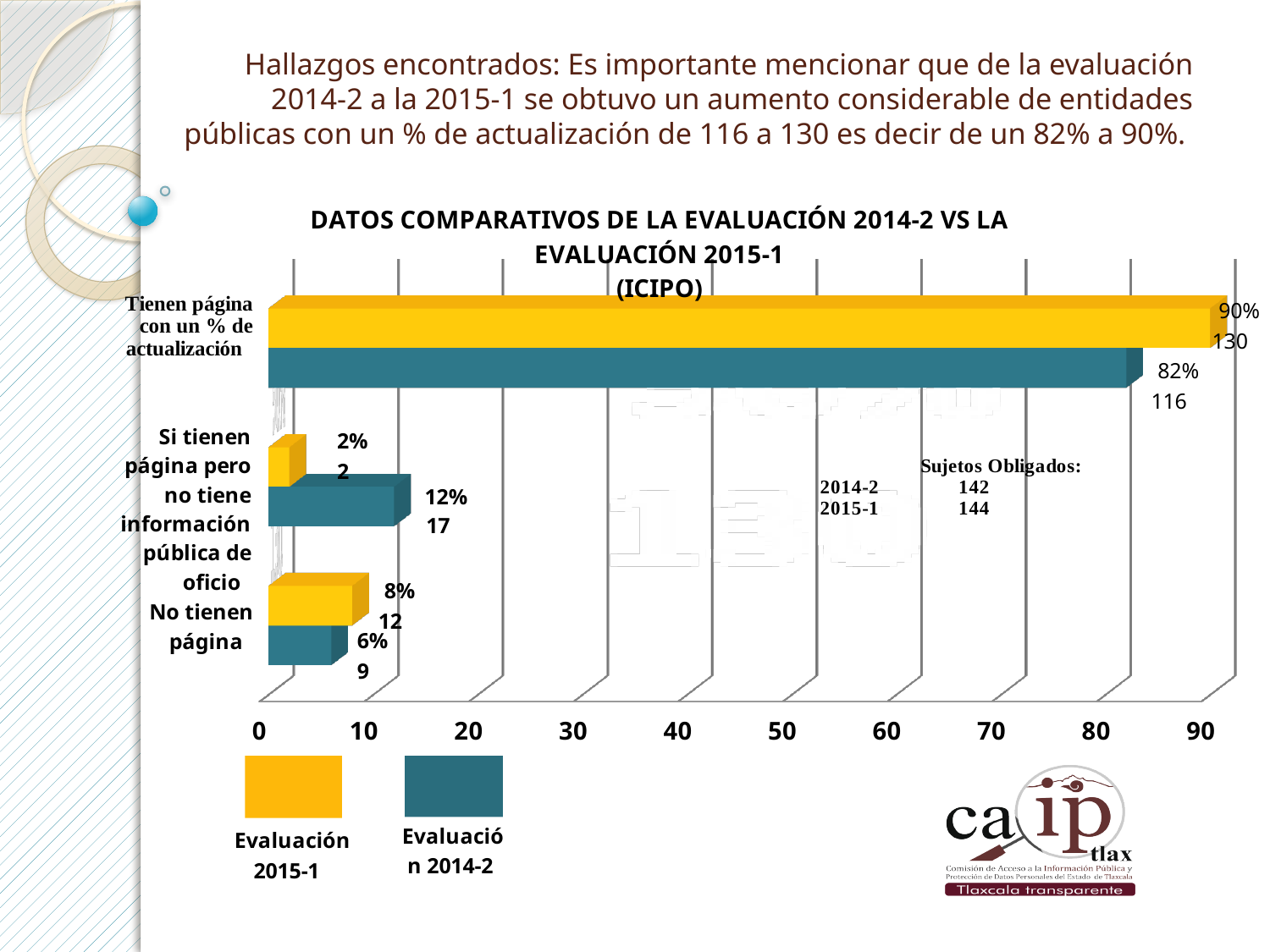
What count is labelled for Evaluación 2015-1 in the category 'No tienen página'? 12 How many series does the legend list? 2 What type of chart is shown on the slide? bar chart Which category has the highest value for Evaluación 2015-1? Tienen página con un % de actualización How many categories are shown on the chart? 3 Which colour represents Evaluación 2014-2 in the legend? teal What percentage is labelled for Evaluación 2014-2 in the category 'Si tienen página pero no tiene información pública de oficio'? 12% In the category 'No tienen página', which series has the larger value, Evaluación 2015-1 or Evaluación 2014-2? Evaluación 2015-1 What count is labelled for Evaluación 2014-2 in the category 'Tienen página con un % de actualización'? 116 Which category has the lowest value for Evaluación 2015-1? Si tienen página pero no tiene información pública de oficio What percentage is labelled for Evaluación 2015-1 in the category 'Tienen página con un % de actualización'? 90% What is the difference in counts between Evaluación 2015-1 and Evaluación 2014-2 for 'Tienen página con un % de actualización'? 14